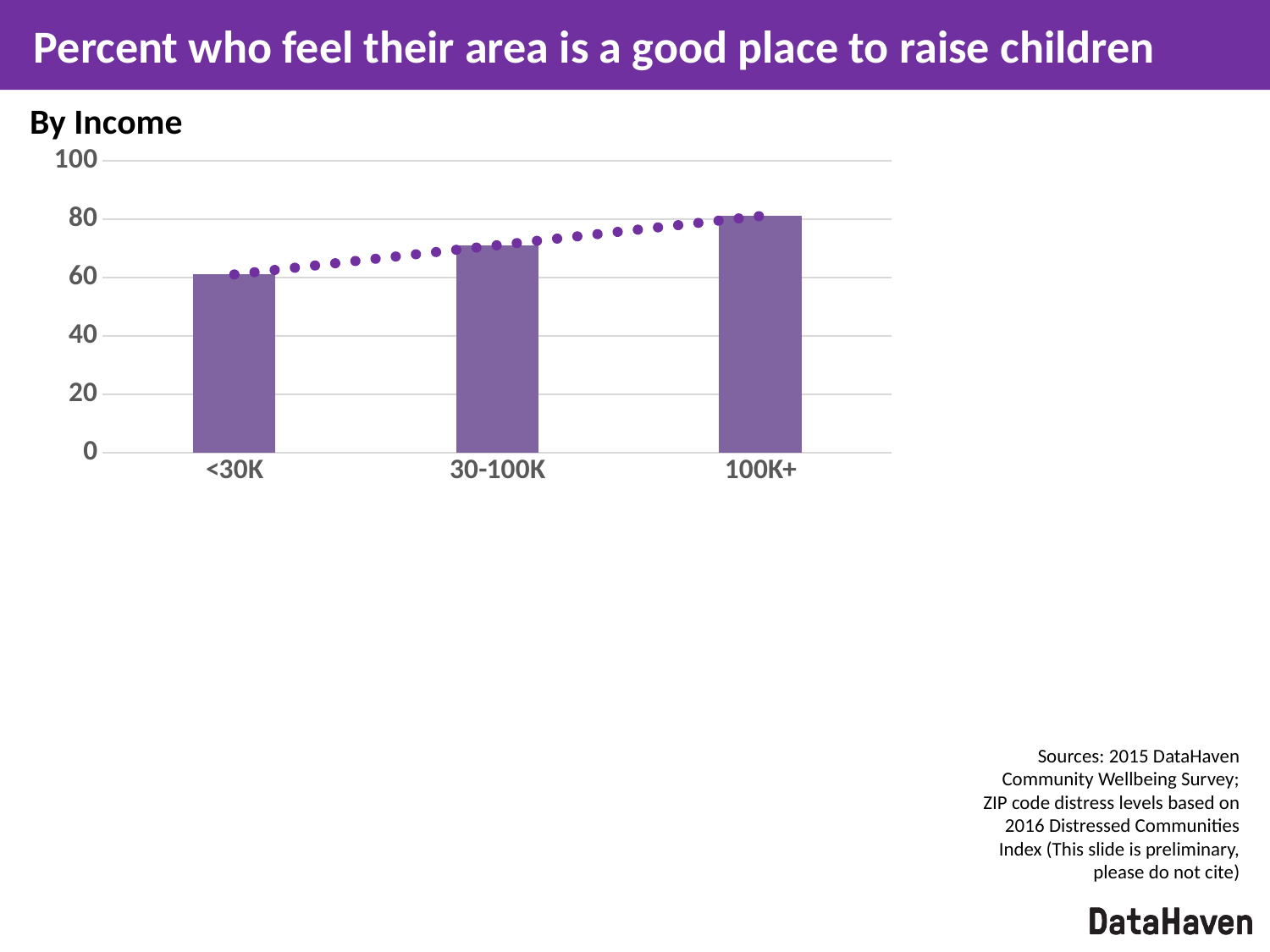
Is the value for <30K greater or less than 80? less Which is larger, the value for 30-100K or the value for <30K? 30-100K Which is larger, the value for <30K or the value for 100K+? 100K+ Which income group has the highest percent who feel their area is a good place to raise children? 100K+ What is the subtitle shown above the chart? By Income How many income categories are shown on the x axis? 3 Do the values rise or fall as income increases from <30K to 100K+? rise Which income group has the lowest percent who feel their area is a good place to raise children? <30K Is the value for 30-100K greater or less than 60? greater What is the title of the chart? Percent who feel their area is a good place to raise children What kind of chart is shown on the slide? bar chart Is the value for 100K+ greater or less than 60? greater